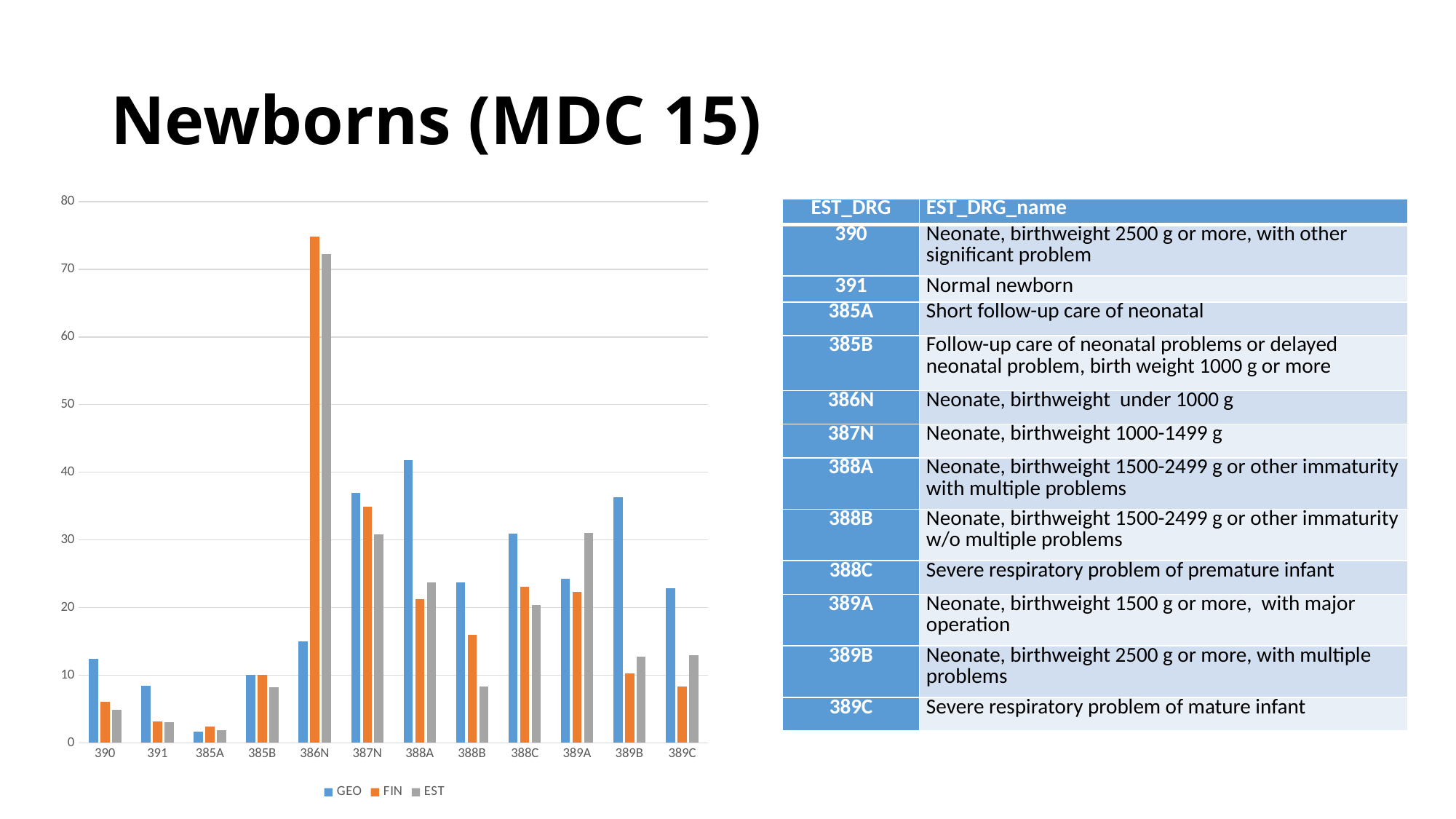
Is the GEO value for 388A greater or less than 40? greater Which category has the highest FIN value? 386N What kind of chart is shown on the slide? bar chart For 389A, which is larger: the EST value or the GEO value? EST For 389B, which is larger: the GEO value or the FIN value? GEO Is the EST value for 388B greater or less than 10? less How many categories are shown on the x axis of the chart? 12 Which category has the lowest GEO value? 385A How many series does the chart's legend list? 3 Is the FIN value for 386N greater or less than 70? greater What are the series names listed in the chart's legend? GEO, FIN, EST